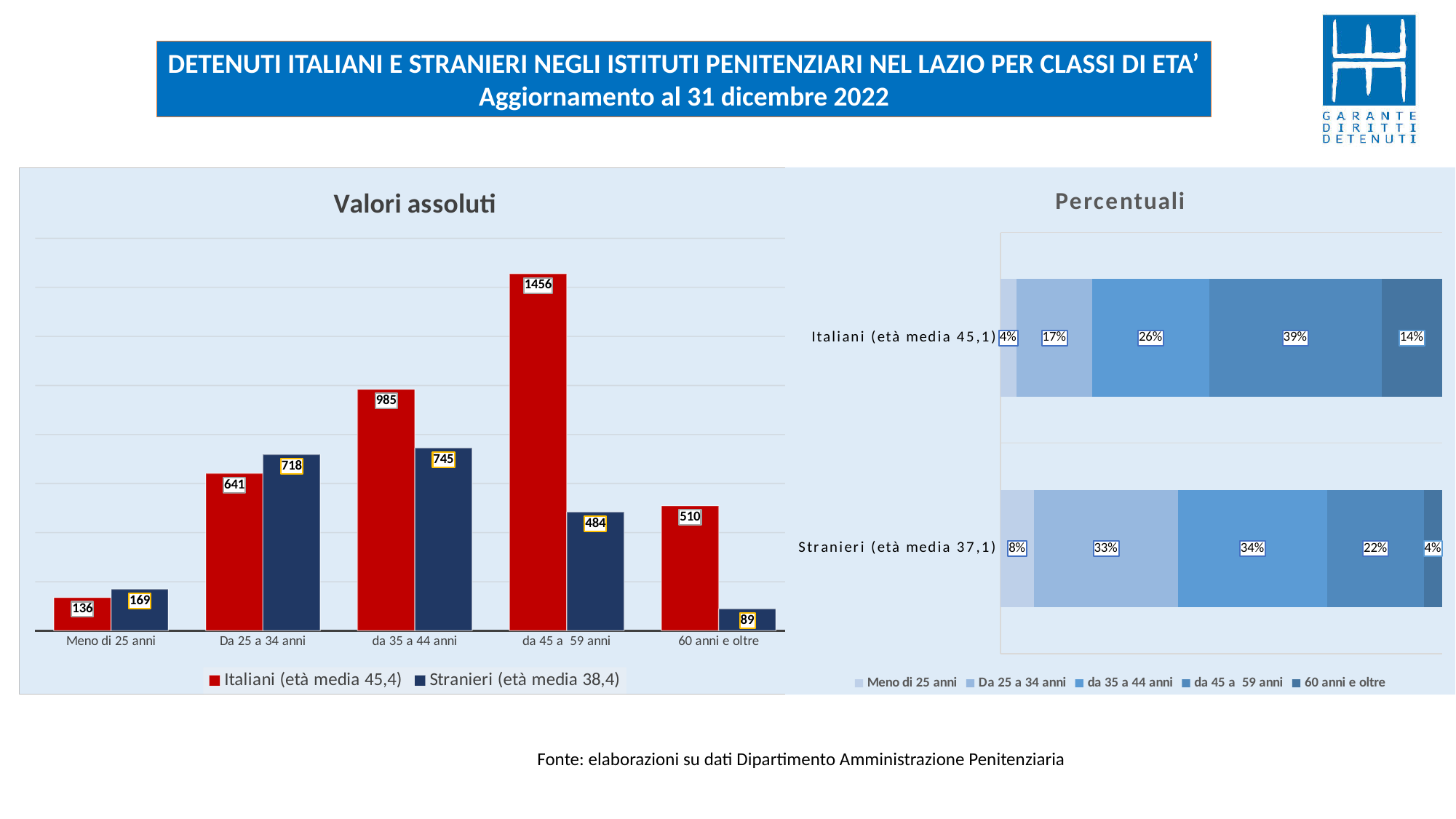
In the 'Valori assoluti' chart, what is the difference between Italiani and Stranieri in the 'da 45 a 59 anni' age class? 972 What kind of chart is the 'Percentuali' chart? Stacked bar chart In the 'Percentuali' chart, what is the share of the 'da 45 a 59 anni' age class for Italiani (età media 45,1)? 39% How many series does the legend of the 'Valori assoluti' chart list? 2 In the 'Percentuali' chart, what is the share of the 'Da 25 a 34 anni' age class for Stranieri (età media 37,1)? 33% How many series does the legend of the 'Percentuali' chart list? 5 How many age classes are shown on the x axis of the 'Valori assoluti' chart? 5 In the 'Valori assoluti' chart, which age class has the lowest value for Stranieri? 60 anni e oltre In the 'Valori assoluti' chart, what is the value for Italiani in the 'da 45 a 59 anni' age class? 1456 In the 'Valori assoluti' chart, which age class has the highest value for Italiani? da 45 a 59 anni In the 'Valori assoluti' chart, which is larger in the 'da 35 a 44 anni' age class: Italiani or Stranieri? Italiani In the 'Valori assoluti' chart, what is the value for Stranieri in the 'Da 25 a 34 anni' age class? 718